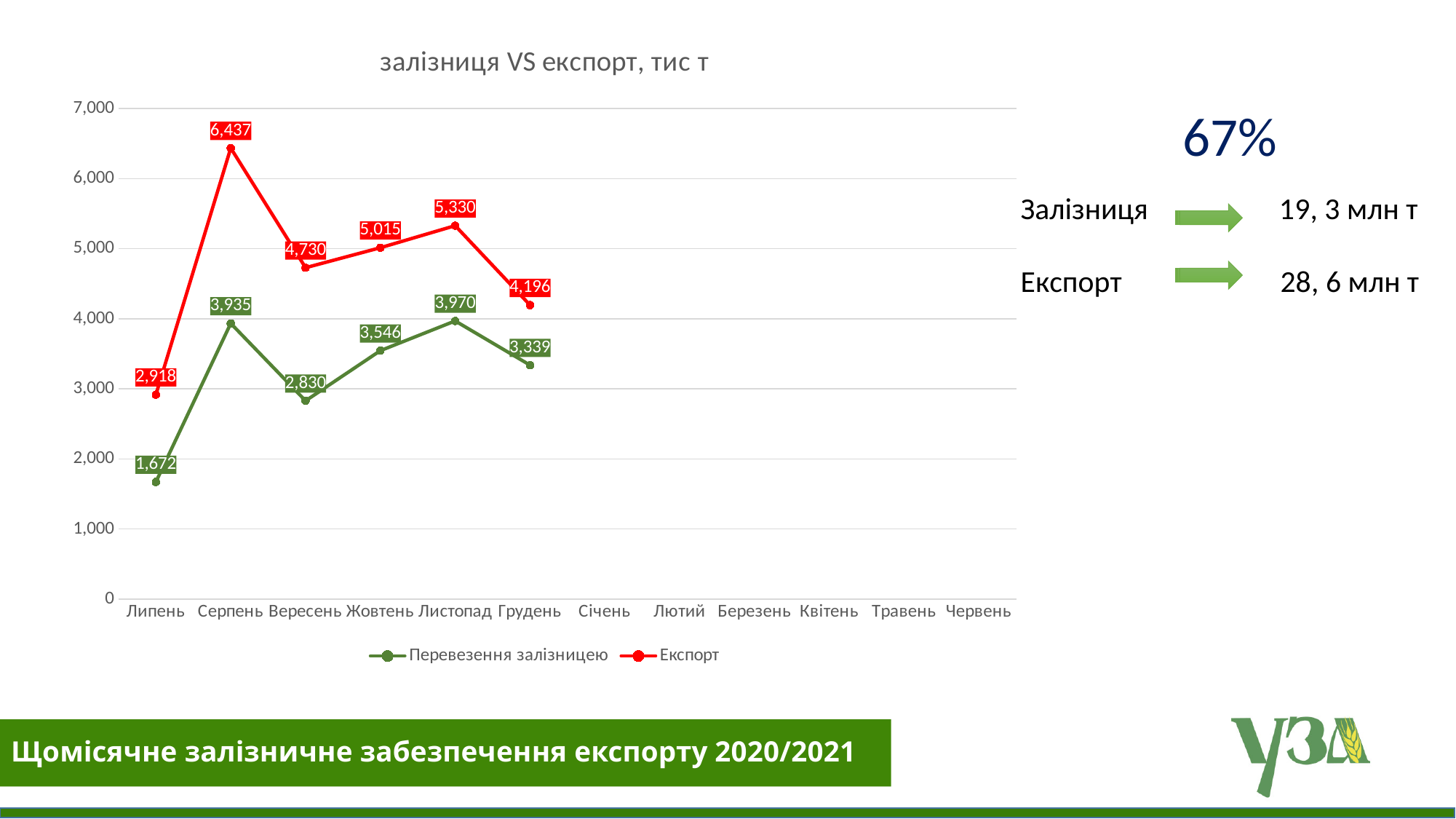
In which month is Перевезення залізницею lowest? Липень What is the difference between Експорт and Перевезення залізницею in Листопад? 1,360 What is the value of Перевезення залізницею for Жовтень? 3,546 Does the Перевезення залізницею series rise or fall from Листопад to Грудень? fall How many series does the legend list? 2 How many months have plotted data points for the Експорт series? 6 What is the value of Експорт for Грудень? 4,196 In which month is Експорт highest? Серпень What type of chart is shown on the slide? line chart What is the value of Експорт for Серпень? 6,437 Which is larger in Вересень: Експорт or Перевезення залізницею? Експорт What is the title of the chart? залізниця VS експорт, тис т